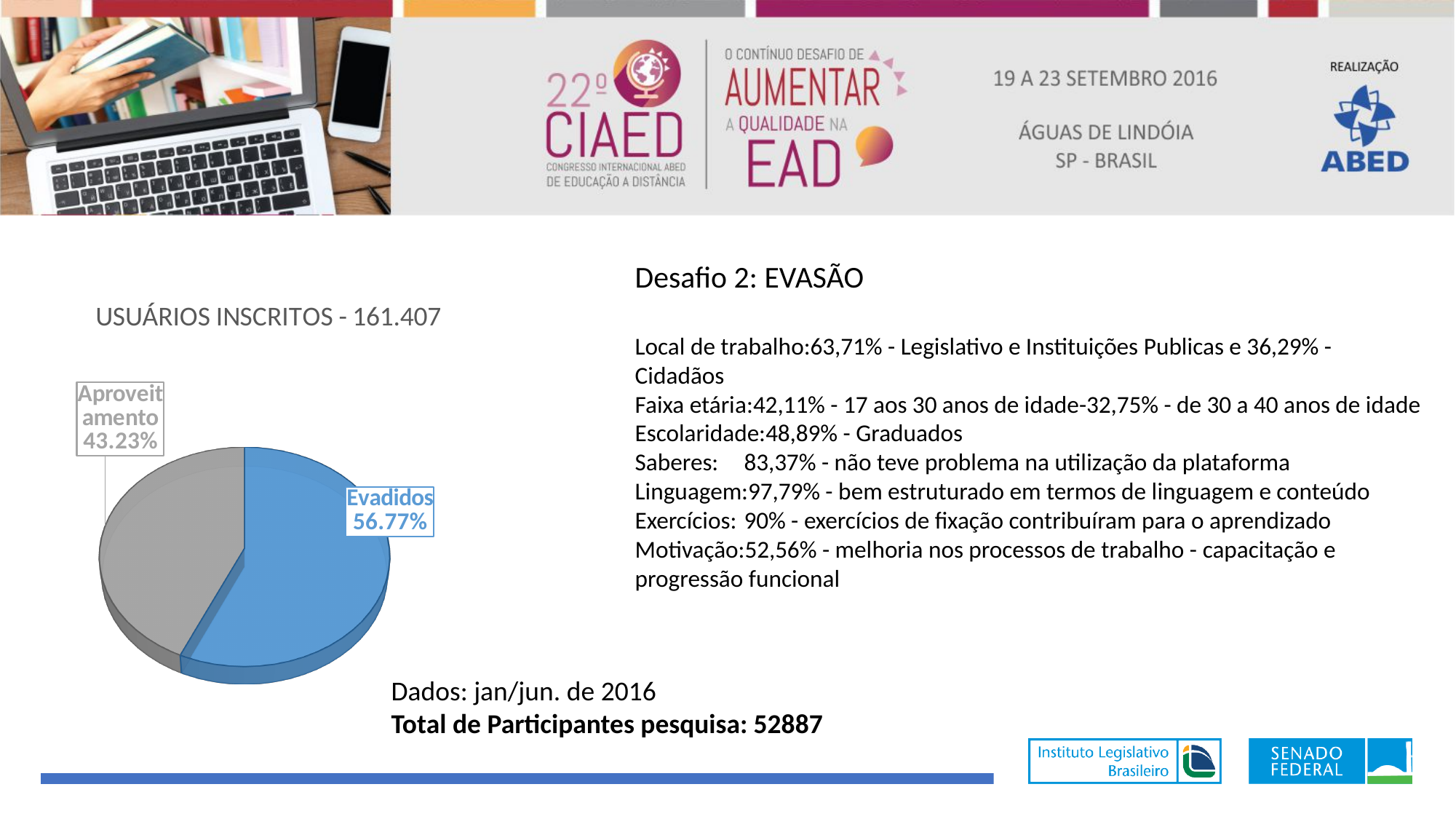
What is the title of the pie chart? USUÁRIOS INSCRITOS - 161.407 What colour is the Evadidos slice in the pie chart? blue What percentage of the pie chart is labelled Evadidos? 56.77% What percentage of the pie chart is labelled Aproveitamento? 43.23% Which is larger in the pie chart, Evadidos or Aproveitamento? Evadidos Which slice of the pie chart is the smallest? Aproveitamento How many slices does the pie chart have? 2 Which slice of the pie chart is the largest? Evadidos What is the difference in percentage points between the Evadidos and Aproveitamento slices? 13.54 What kind of chart is shown on the slide? pie chart What share of the pie does the Evadidos slice represent? 56.77%